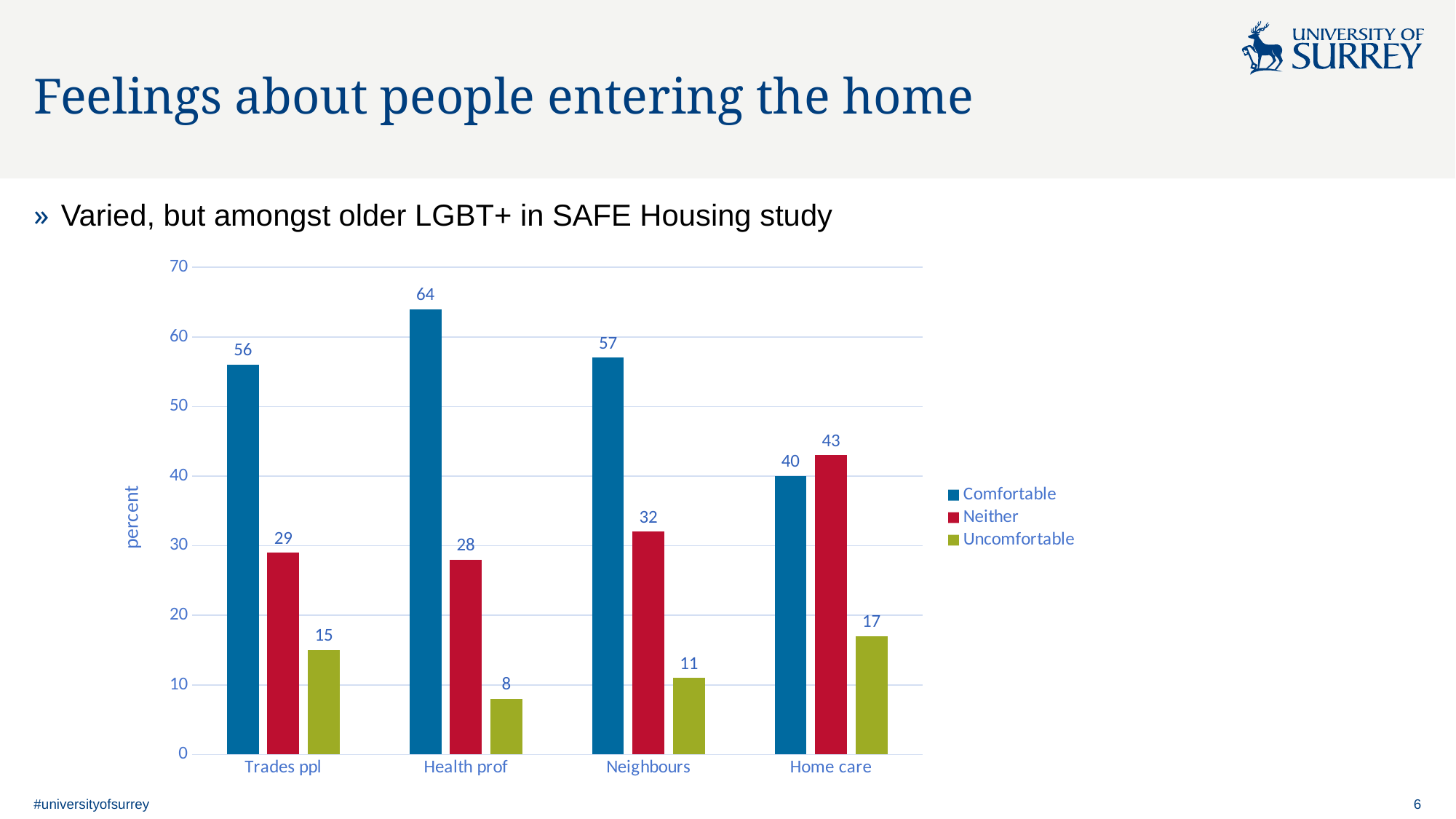
Which category has the lowest Uncomfortable value? Health prof How many categories are shown on the x axis? 4 What is the Uncomfortable value for Neighbours? 11 What is the difference between the Comfortable and Neither values for Trades ppl? 27 What is the Comfortable value for Health prof? 64 Which is larger for Home care, the Comfortable value or the Neither value? Neither What is the label of the y axis? percent How many series does the legend list? 3 Which series is shown in green? Uncomfortable Which category has the highest Comfortable value? Health prof What kind of chart is shown on the slide? Bar chart What is the Neither value for Home care? 43